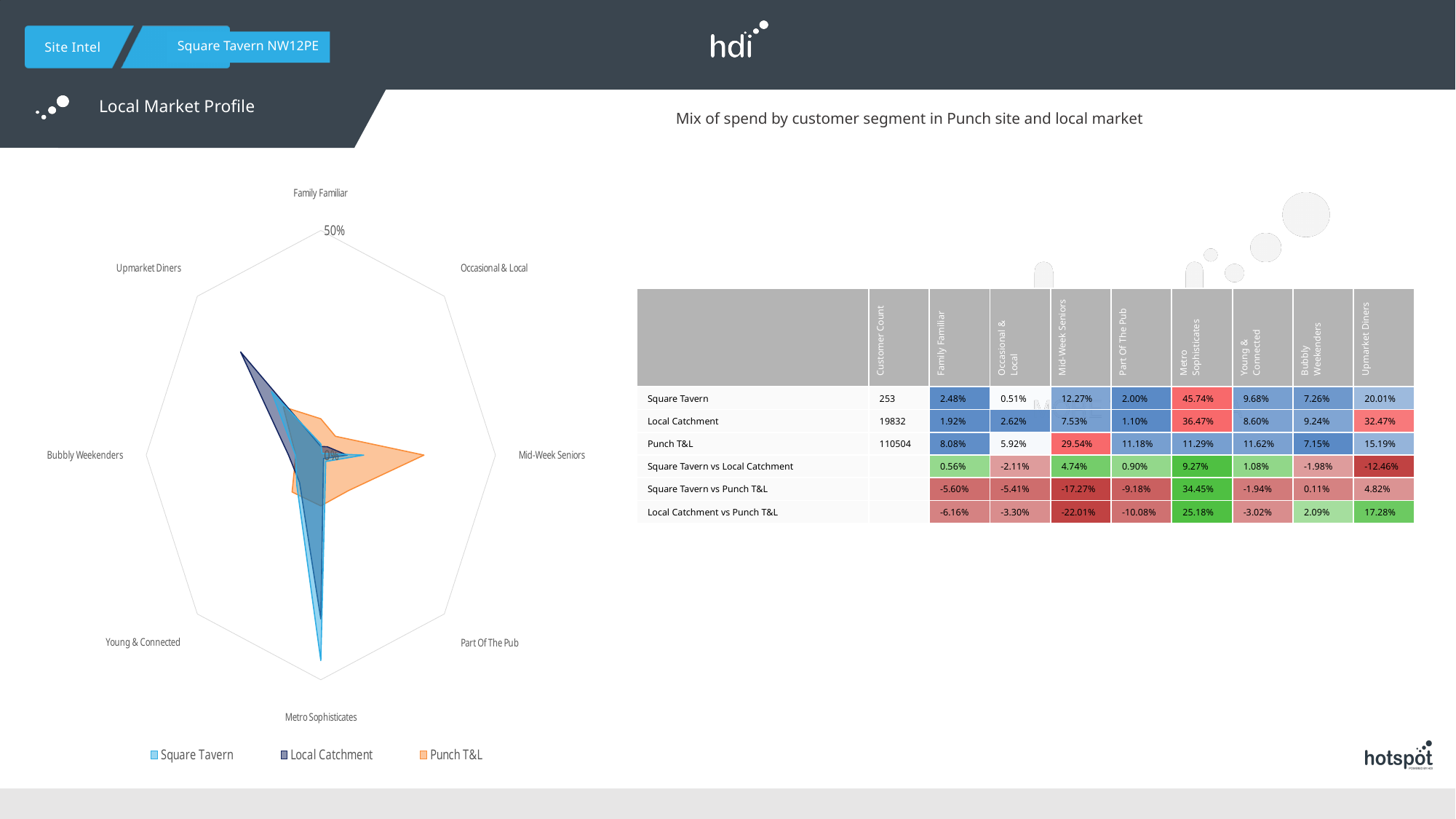
How many series does the radar chart's legend list? 3 Is the Square Tavern value for Metro Sophisticates greater or less than 50%? less How many customer segment axes does the radar chart have? 8 Which customer segment has the lowest value for Square Tavern? Occasional & Local What is the difference between the Square Tavern and Local Catchment values for Metro Sophisticates? 9.27% What is the Local Catchment value for Upmarket Diners? 32.47% What is the Square Tavern value for Metro Sophisticates? 45.74% Which is larger for Upmarket Diners: Square Tavern or Local Catchment? Local Catchment Which customer segment has the highest value for Punch T&L? Mid-Week Seniors What kind of chart is shown on the left of the slide? Radar chart Which customer segment has the highest value for Square Tavern? Metro Sophisticates What is the Punch T&L value for Mid-Week Seniors? 29.54%